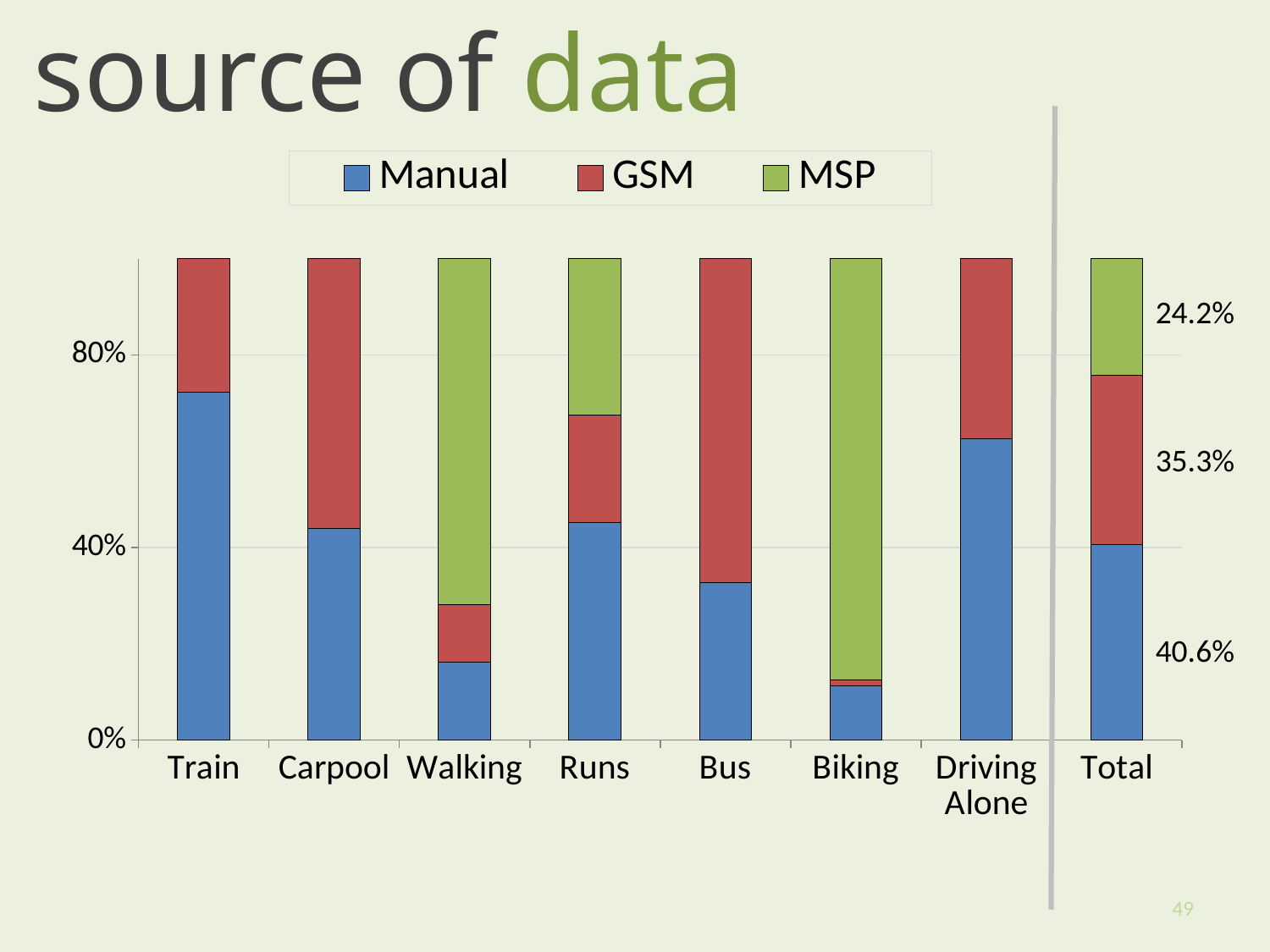
What is the Manual share shown for the Total bar? 40.6% What are the three series named in the legend? Manual, GSM, MSP What is the MSP share shown for the Total bar? 24.2% How many series does the legend list? 3 Which is larger, the Manual share for Driving Alone or the Manual share for Walking? Driving Alone What is the GSM share shown for the Total bar? 35.3% How many categories are shown along the x axis? 8 What kind of chart is shown on the slide? Stacked bar chart Is the Manual share for Train greater or less than 40%? greater Which category has the largest Manual segment? Train In the Total bar, how many percentage points larger is the Manual share than the MSP share? 16.4 percentage points Is the Manual share for Biking greater or less than 40%? less